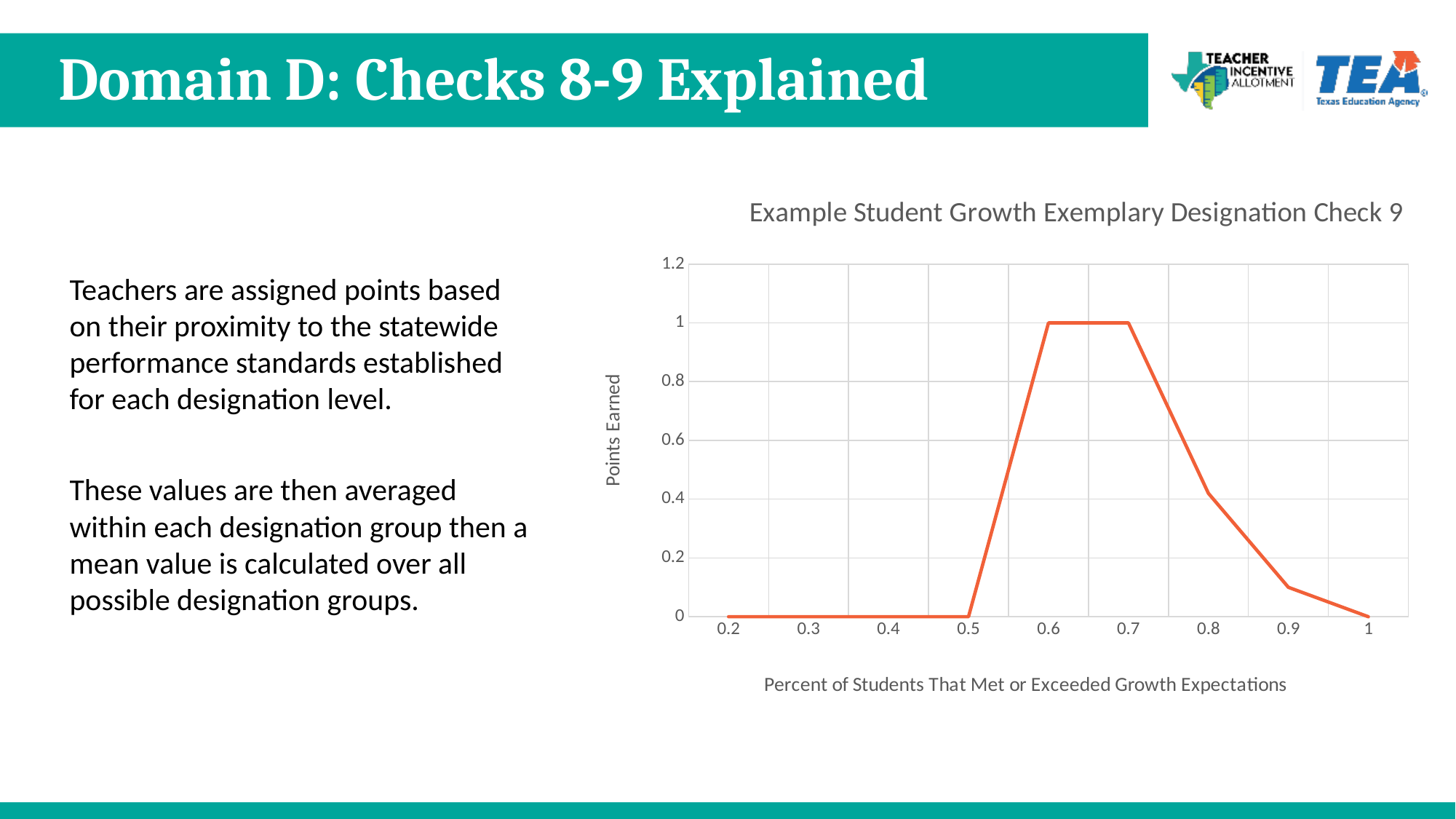
Do the points earned values rise or fall along the x axis from 0.7 to 1? fall What is the points earned value at 0.4 on the x axis? 0 Which has a higher points earned value, 0.6 or 0.8 on the x axis? 0.6 Is the points earned value at 0.8 greater or less than 0.6? less Is the points earned value at 0.9 greater or less than 0.2? less What kind of chart is shown on the slide? line chart What is the points earned value at 1 on the x axis? 0 What is the label of the y axis? Points Earned How many points earned are shown when the percent of students that met or exceeded growth expectations is 0.6? 1 How many data points are plotted on the line? 9 What is the title of the chart? Example Student Growth Exemplary Designation Check 9 What is the points earned value at 0.7 on the x axis? 1